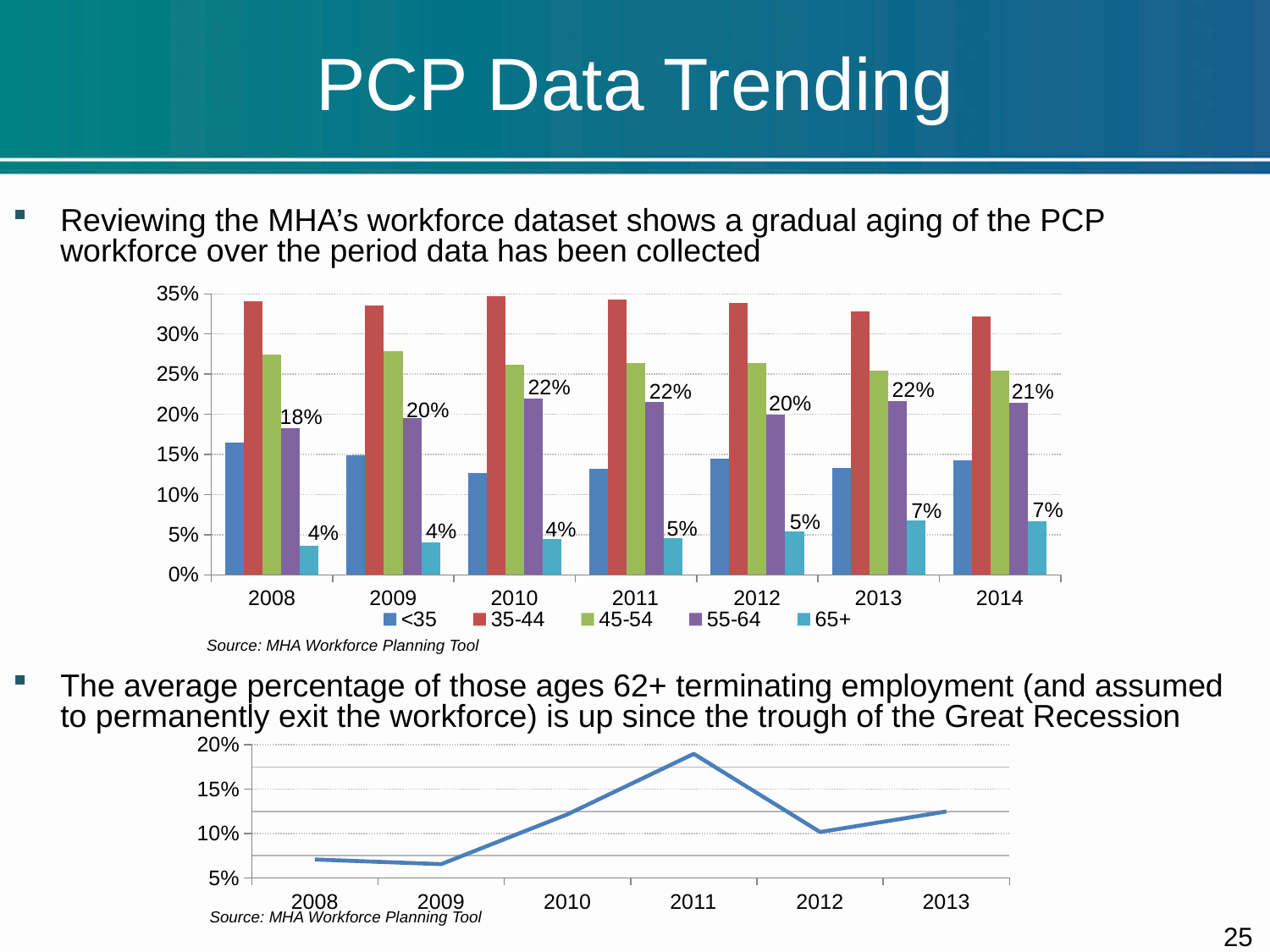
In the top bar chart, what is the value for the 65+ age group in 2013? 7% In the top bar chart, what is the difference between the 65+ values for 2014 and 2008? 3% In the top bar chart, which age group has the lowest share in 2008? 65+ In the top bar chart, is the value for the <35 group in 2008 greater or less than 15%? greater In the top bar chart, how many series does the legend list? 5 In the top bar chart, what is the value for the 55-64 age group in 2014? 21% In the bottom line chart, which year has the highest value? 2011 What kind of chart is the bottom chart on the slide? line chart In the top bar chart, how many years are shown on the x axis? 7 In the top bar chart, what is the value for the 55-64 age group in 2008? 18% In the top bar chart, which age group has the highest share in 2010? 35-44 In the top bar chart, which is larger in 2012: the 55-64 group or the 65+ group? 55-64